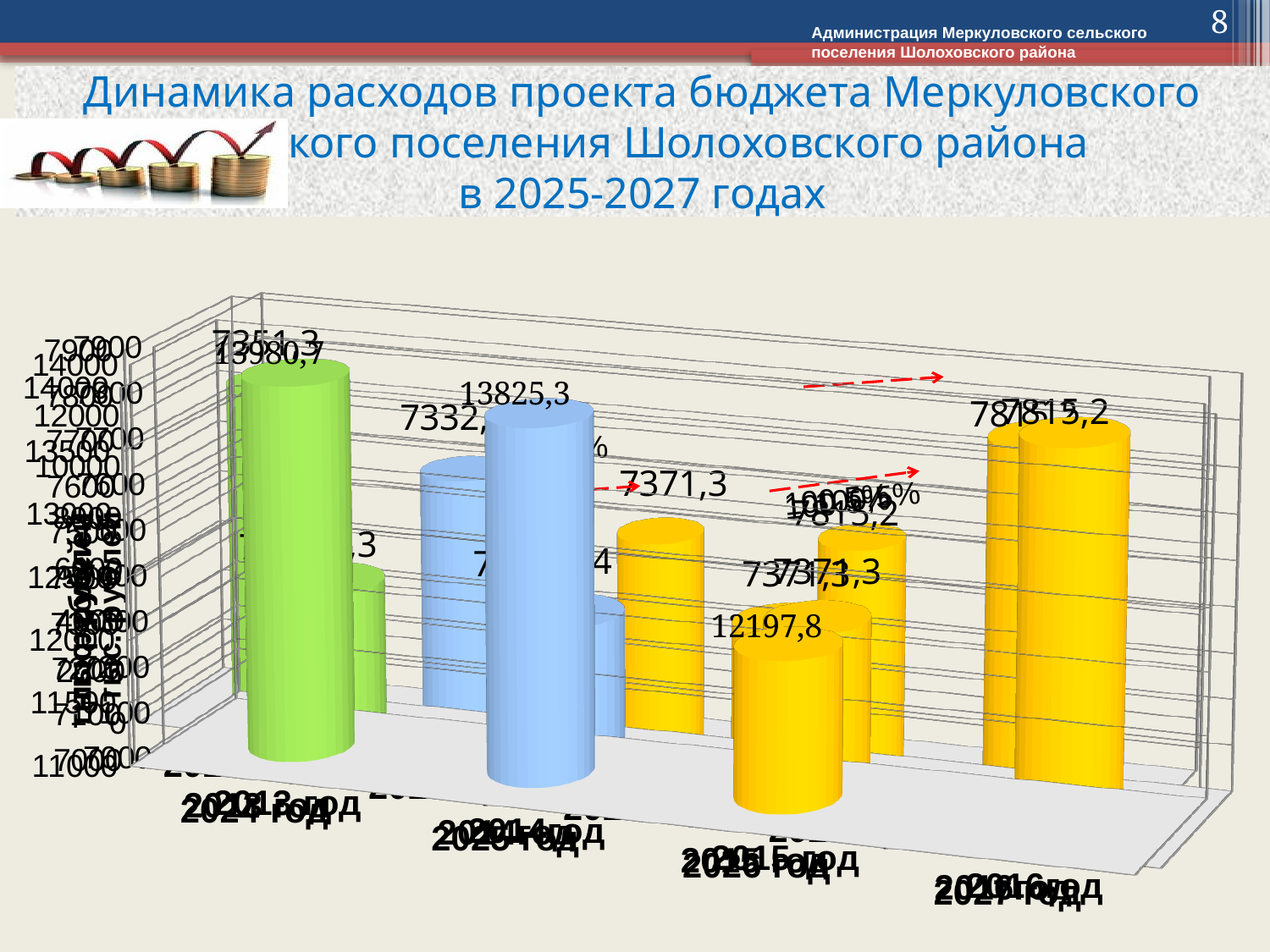
What value is labelled on the tall blue bar at the front of the chart? 13825,3 Which years does the chart title say the budget expenditure dynamics cover? 2025-2027 What value is labelled on the short yellow bar at the front of the chart (third from the left)? 12197,8 What is the title of the slide's chart? Динамика расходов проекта бюджета Меркуловского сельского поселения Шолоховского района в 2025-2027 годах What kind of chart is shown on the slide? bar chart What value is labelled on the tall green bar at the front left of the chart? 13980,7